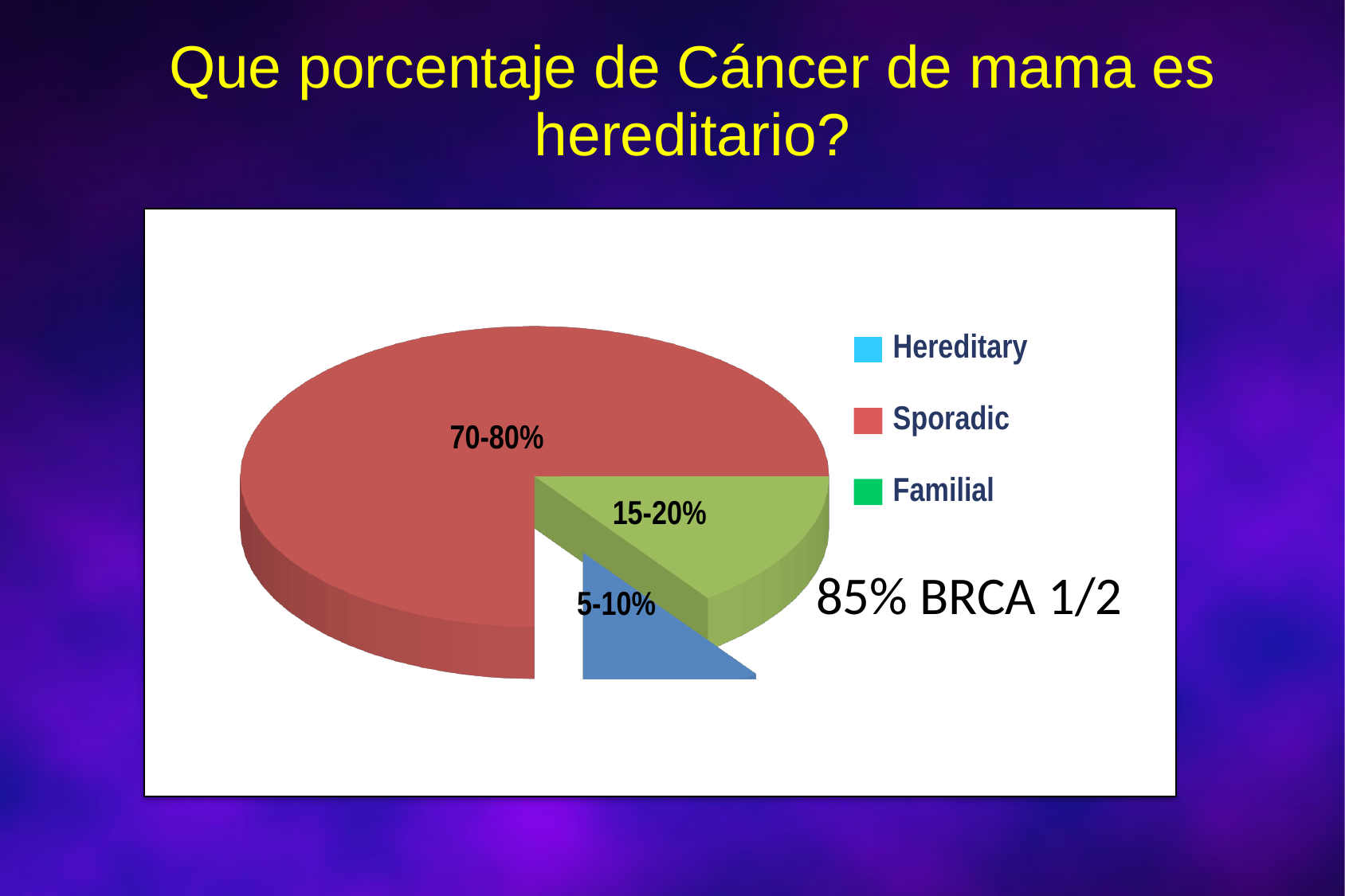
How many slices does the pie chart have? 3 Which category has the largest slice of the pie chart? Sporadic What percentage label is shown on the Sporadic slice of the pie chart? 70-80% What kind of chart is shown on the slide? pie chart Which slice is larger in the pie chart, Familial or Hereditary? Familial What text is printed next to the pie chart below the legend? 85% BRCA 1/2 What colour is the Sporadic slice in the pie chart? red What percentage label is shown on the Familial slice of the pie chart? 15-20% What percentage label is shown on the Hereditary slice of the pie chart? 5-10% Which slice is larger in the pie chart, Sporadic or Familial? Sporadic How many entries does the legend of the pie chart list? 3 Which category has the smallest slice of the pie chart? Hereditary